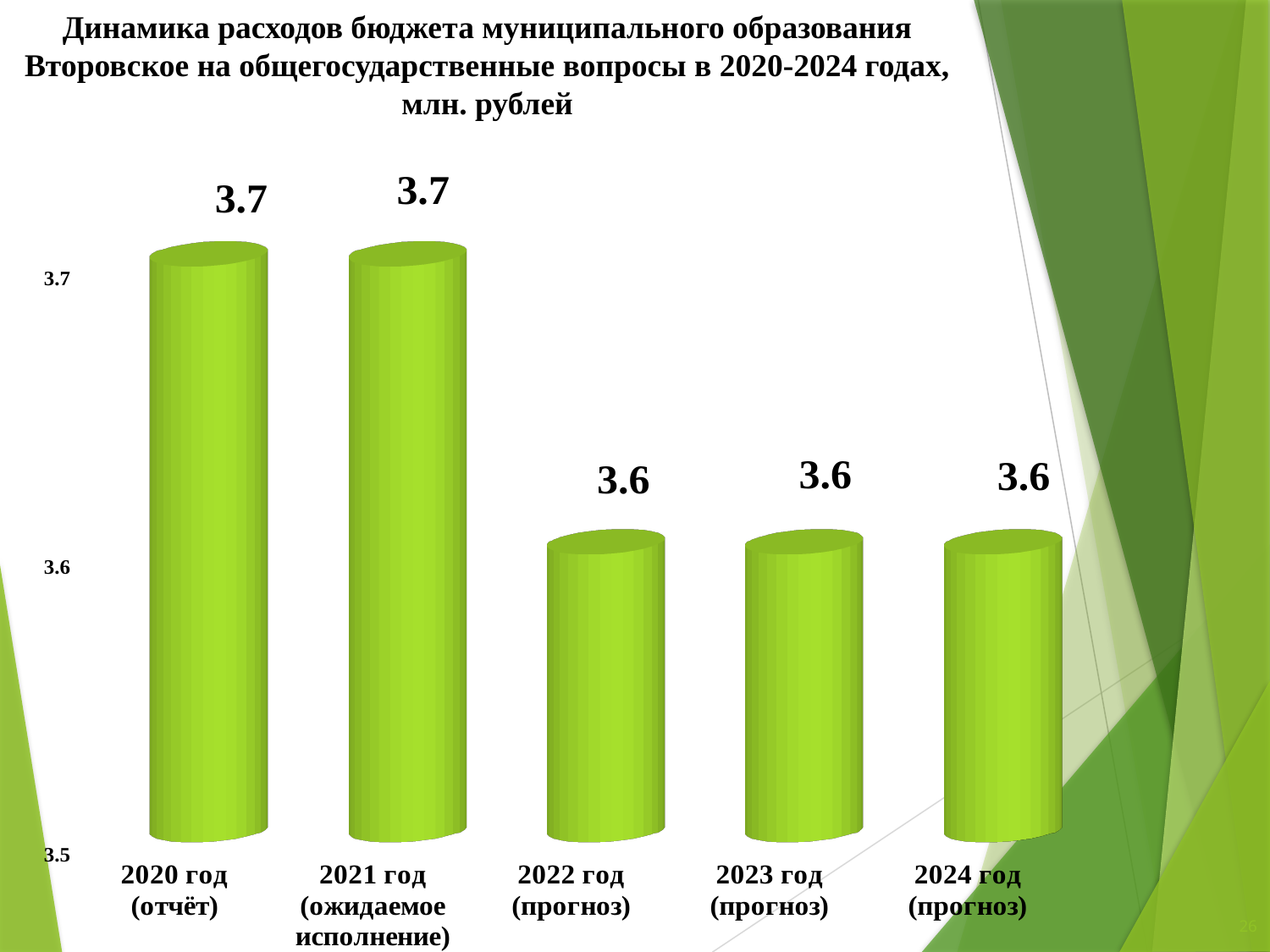
Is the value for 2020 год greater or less than 3.6? greater Which is larger, the value for 2021 год or the value for 2024 год? 2021 год What is the value for 2024 год (прогноз)? 3.6 What is the difference between the values for 2020 год and 2023 год? 0.1 In what units are the values on the chart expressed, according to the title? млн. рублей How many years (categories) are shown on the chart? 5 What is the value for 2021 год (ожидаемое исполнение)? 3.7 What is the value for 2020 год (отчёт)? 3.7 Do the values rise or fall from 2020 to 2024? fall What is the value for 2022 год (прогноз)? 3.6 Which years share the highest value on the chart? 2020 год and 2021 год What kind of chart is shown on the slide? bar chart